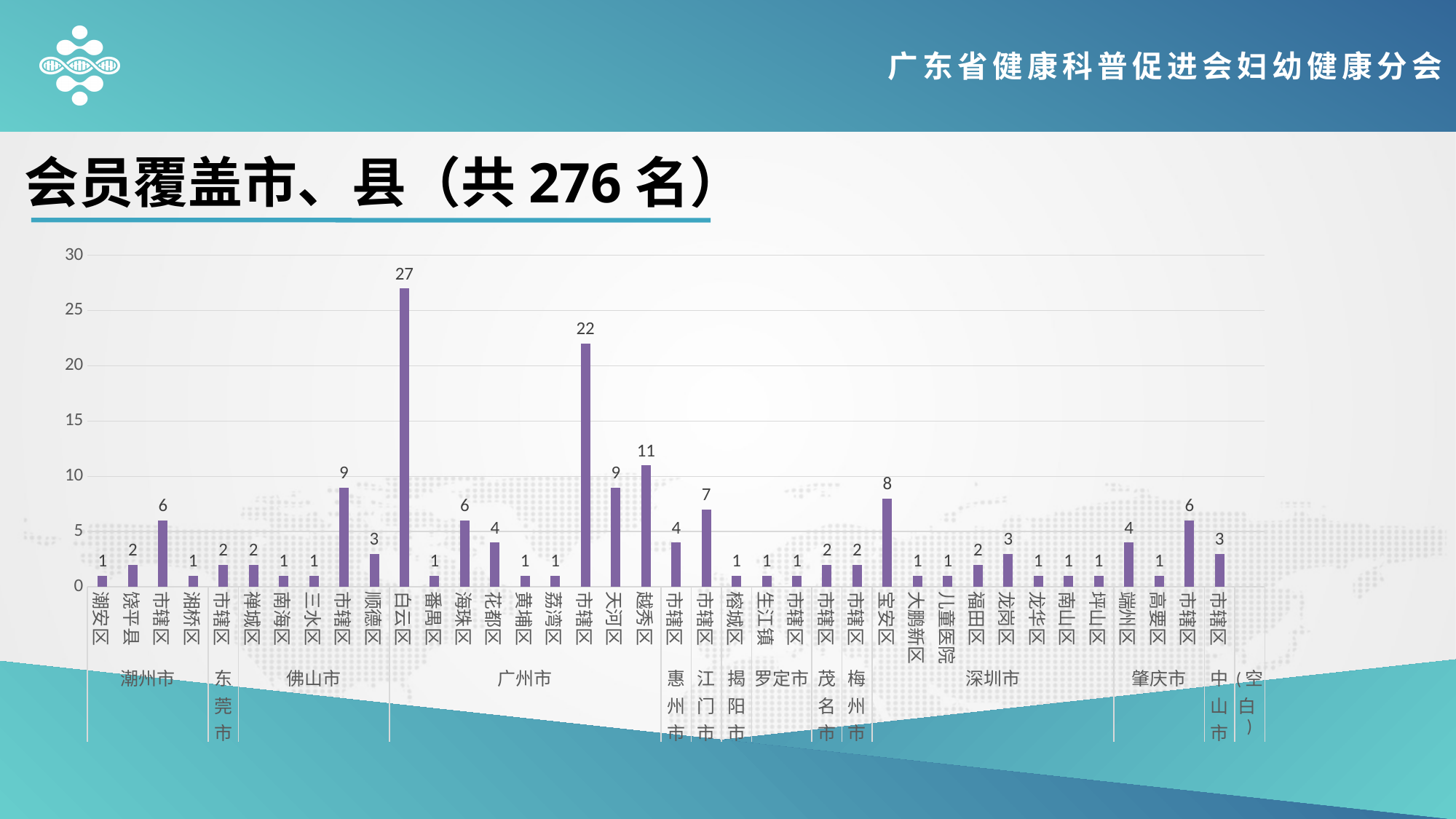
What is the value for 白云区? 27 What is the value for 市辖区 under 肇庆市? 6 What is the value for 宝安区 under 深圳市? 8 How many categories are listed under 深圳市 on the x axis? 8 What type of chart is shown on the slide? bar chart Is the value for 白云区 greater or less than 25? greater Which is larger, the value for 天河区 or the value for 越秀区? 越秀区 What is the difference between the values for 白云区 and 市辖区 under 广州市? 5 Which category has the highest value in the chart? 白云区 What is the value for 越秀区 under 广州市? 11 What is the value for 市辖区 under 江门市? 7 What total number of members is stated in the chart title? 276